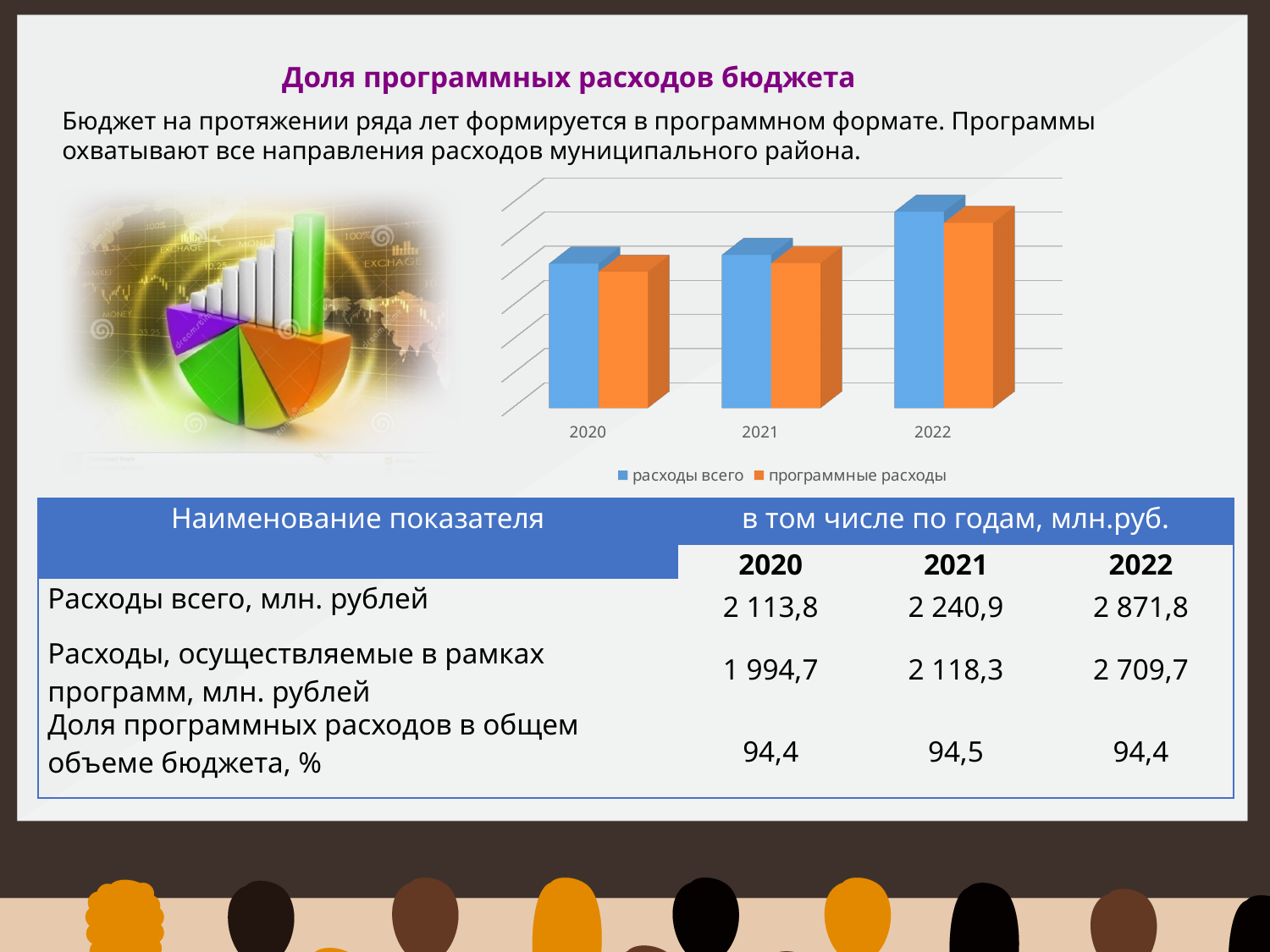
In which year is the value for расходы всего the highest? 2022 In 2022, which is larger: расходы всего or программные расходы? расходы всего Which series is shown in orange in the chart? программные расходы What is the value of программные расходы for 2022, in млн. рублей, as given on the slide? 2 709,7 How many years (categories) are shown on the x axis of the chart? 3 Which series is shown in blue in the chart? расходы всего In which year is the value for программные расходы the lowest? 2020 What kind of chart is shown on the slide? bar chart How many series does the chart legend list? 2 What is the value of расходы всего for 2021, in млн. рублей, as given on the slide? 2 240,9 Do the values for расходы всего rise or fall from 2020 to 2022? rise What is the difference between расходы всего and программные расходы in 2020, in млн. рублей, based on the values given on the slide? 119,1